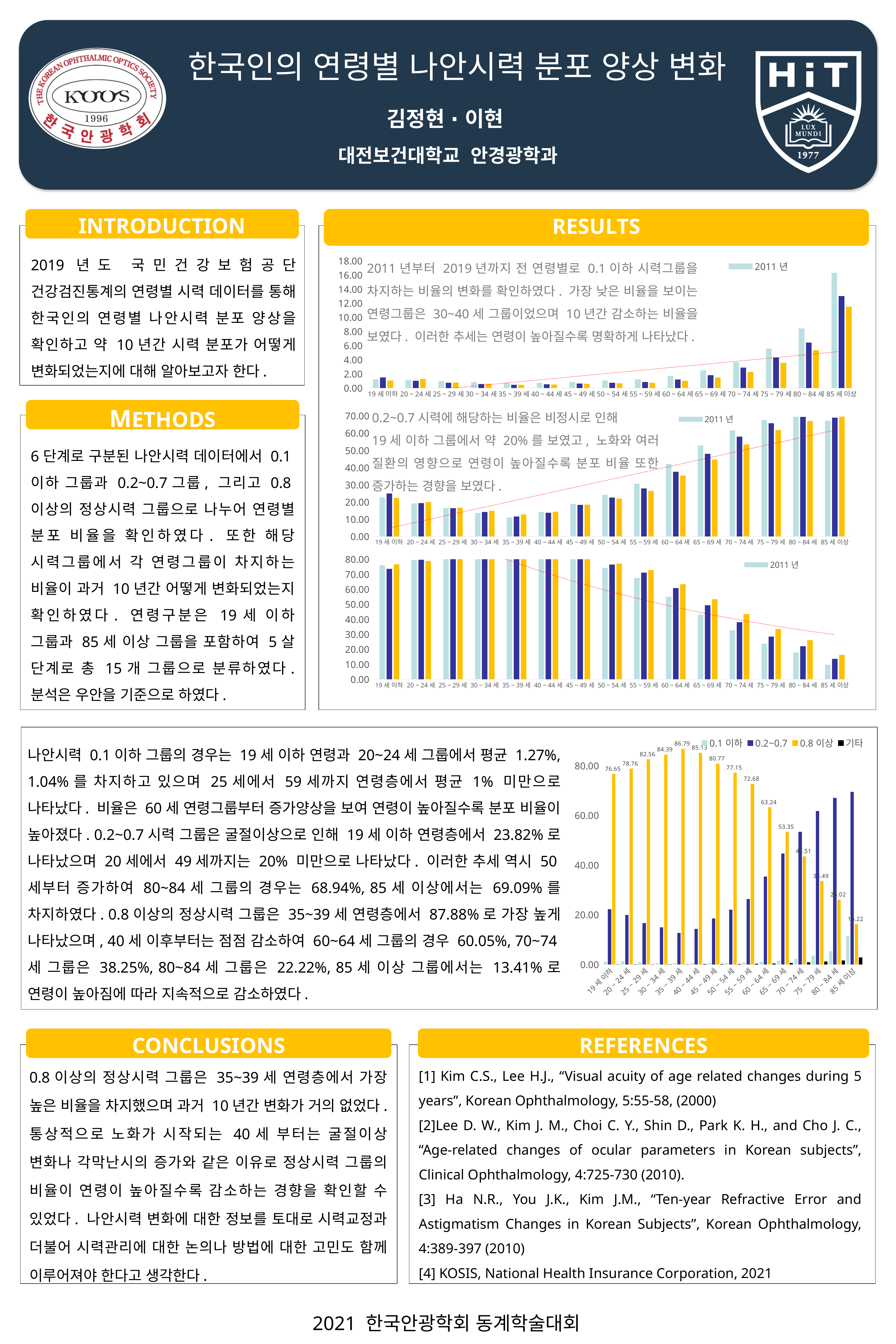
In the bottom-right chart with data labels, what is the value of the 0.8 이상 series for the 19세 이하 group? 76.65 In the bottom-right chart with data labels, which age group has the highest value for the 0.8 이상 series? 35~39세 In the bottom chart of the RESULTS section, do the values generally rise or fall as age increases along the x axis? fall How many series does the legend of the bottom-right chart with data labels list? 4 In the bottom-right chart with data labels, what is the difference between the 0.8 이상 values for 35~39세 and 19세 이하? 10.14 In the bottom-right chart with data labels, what is the value of the 0.8 이상 series for the 60~64세 group? 63.24 In the top chart of the RESULTS section, is the value of the 2011 년 series for 85세 이상 greater or less than 14.00? greater In the bottom-right chart with data labels, which is larger for the 0.8 이상 series: 25~29세 or 20~24세? 25~29세 How many age groups are shown on the x axis of the bottom-right chart with data labels? 15 What kind of chart is the top chart in the RESULTS section? bar chart In the bottom-right chart with data labels, what is the value of the 0.8 이상 series for the 35~39세 group? 86.79 In the bottom-right chart with data labels, which age group has the lowest value for the 0.8 이상 series? 85세 이상